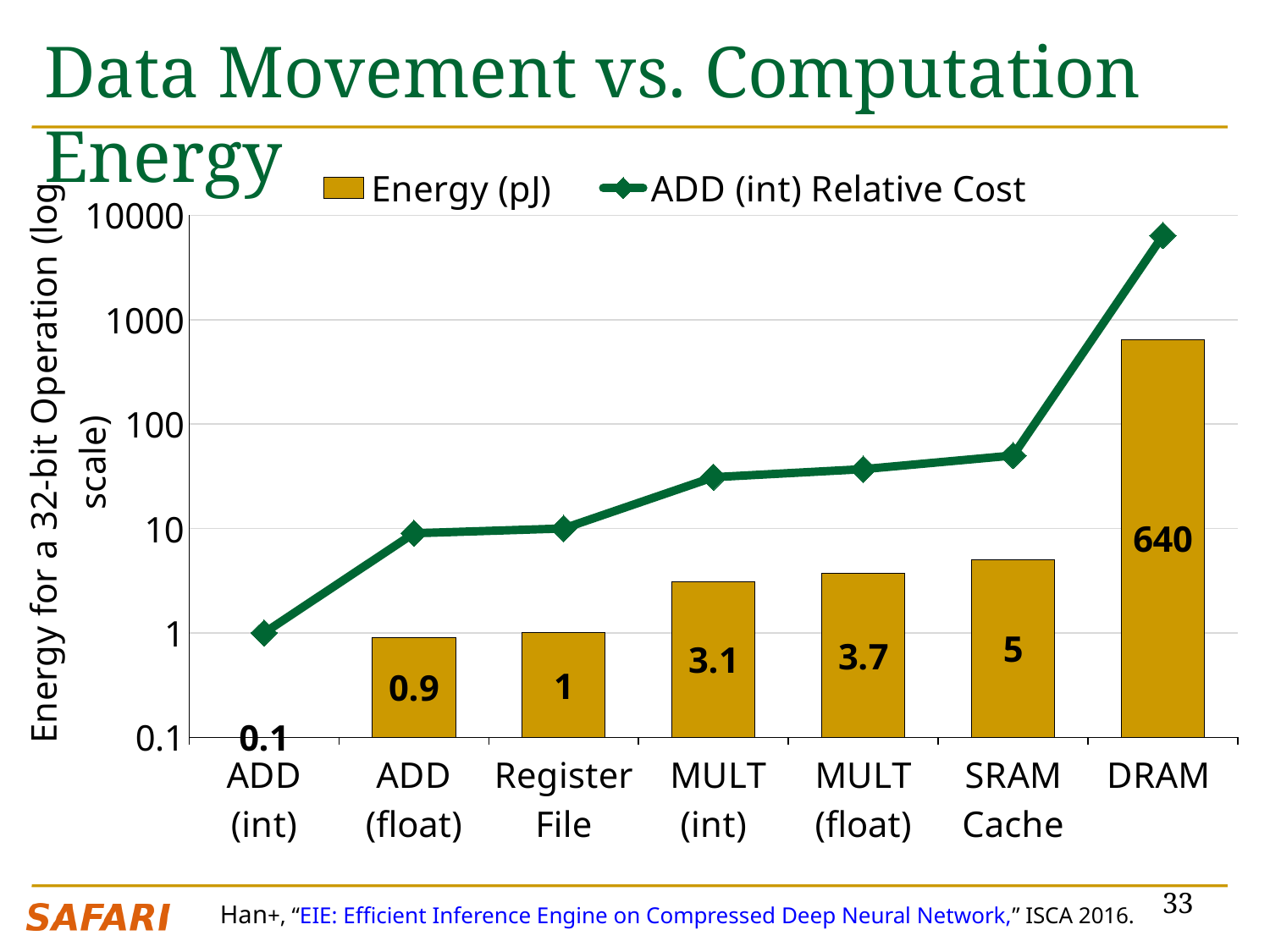
Which category has the highest Energy (pJ)? DRAM What is the Energy (pJ) value for ADD (int)? 0.1 What is the difference in Energy (pJ) between DRAM and SRAM Cache? 635 Which has a higher Energy (pJ) value, MULT (int) or ADD (float)? MULT (int) Is the ADD (int) Relative Cost value for DRAM greater or less than 1000? greater Does the ADD (int) Relative Cost line rise or fall from ADD (int) to DRAM? rise What is the Energy (pJ) value for SRAM Cache? 5 Which category has the lowest Energy (pJ)? ADD (int) How many categories are shown on the x axis? 7 What is the Energy (pJ) value for MULT (float)? 3.7 What is the Energy (pJ) value for DRAM? 640 How many series does the legend list? 2